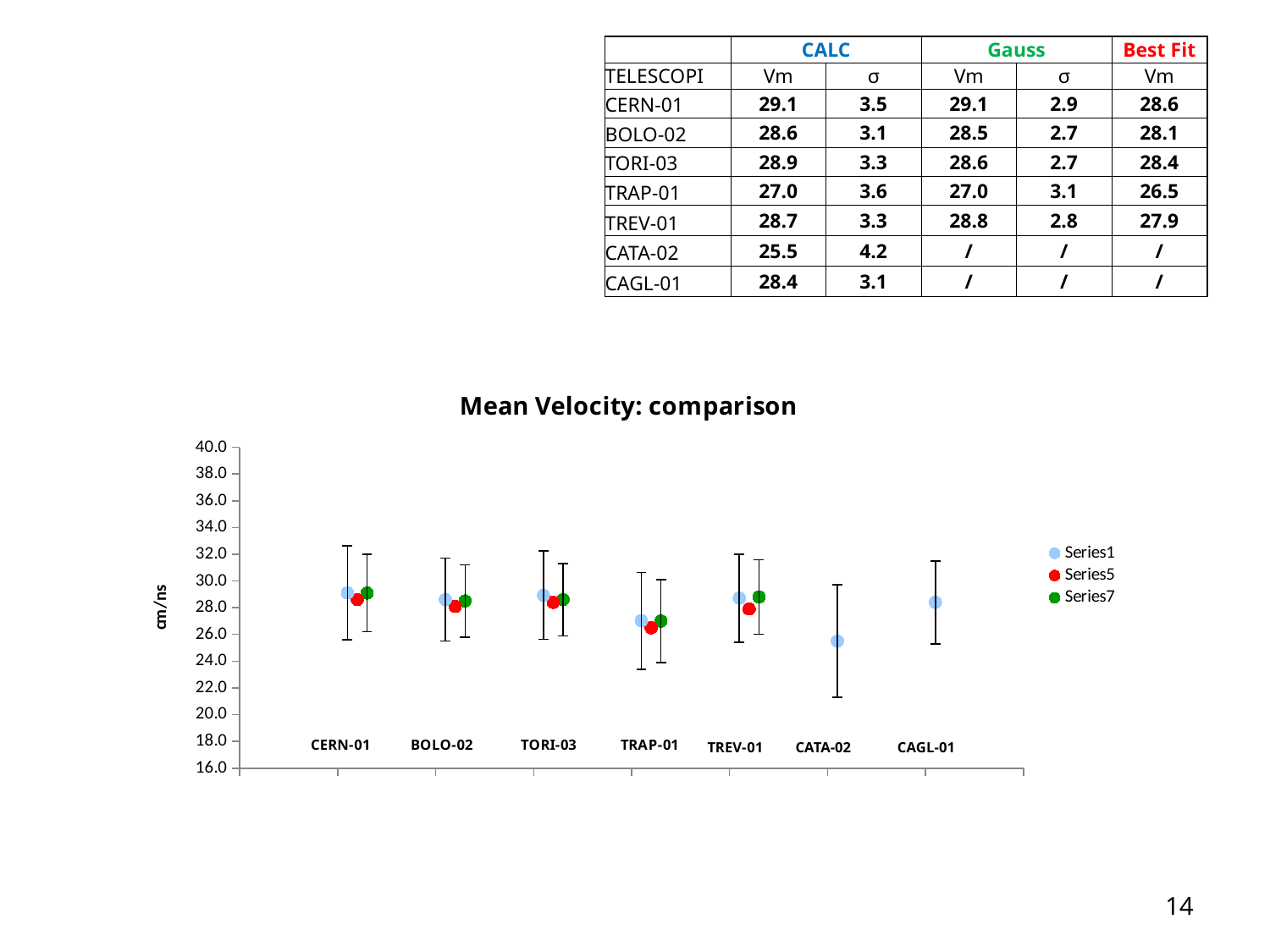
Which category has the lowest Series1 value in the chart? CATA-02 Which is larger in the chart: the Series1 value for CATA-02 or the Series1 value for CAGL-01? CAGL-01 Which is larger in the chart: the Series1 value for CERN-01 or the Series1 value for TRAP-01? CERN-01 How many telescope categories are plotted along the x axis of the chart? 7 Is the Series1 value for CERN-01 greater or less than 28.0? greater Which category has the lowest Series7 value in the chart? TRAP-01 What is the title of the chart? Mean Velocity: comparison How many series does the chart legend list? 3 Which category has the lowest Series5 value in the chart? TRAP-01 What kind of chart is shown under the title "Mean Velocity: comparison"? scatter chart Is the Series1 value for CATA-02 greater or less than 28.0? less What unit is shown on the y axis of the chart? cm/ns